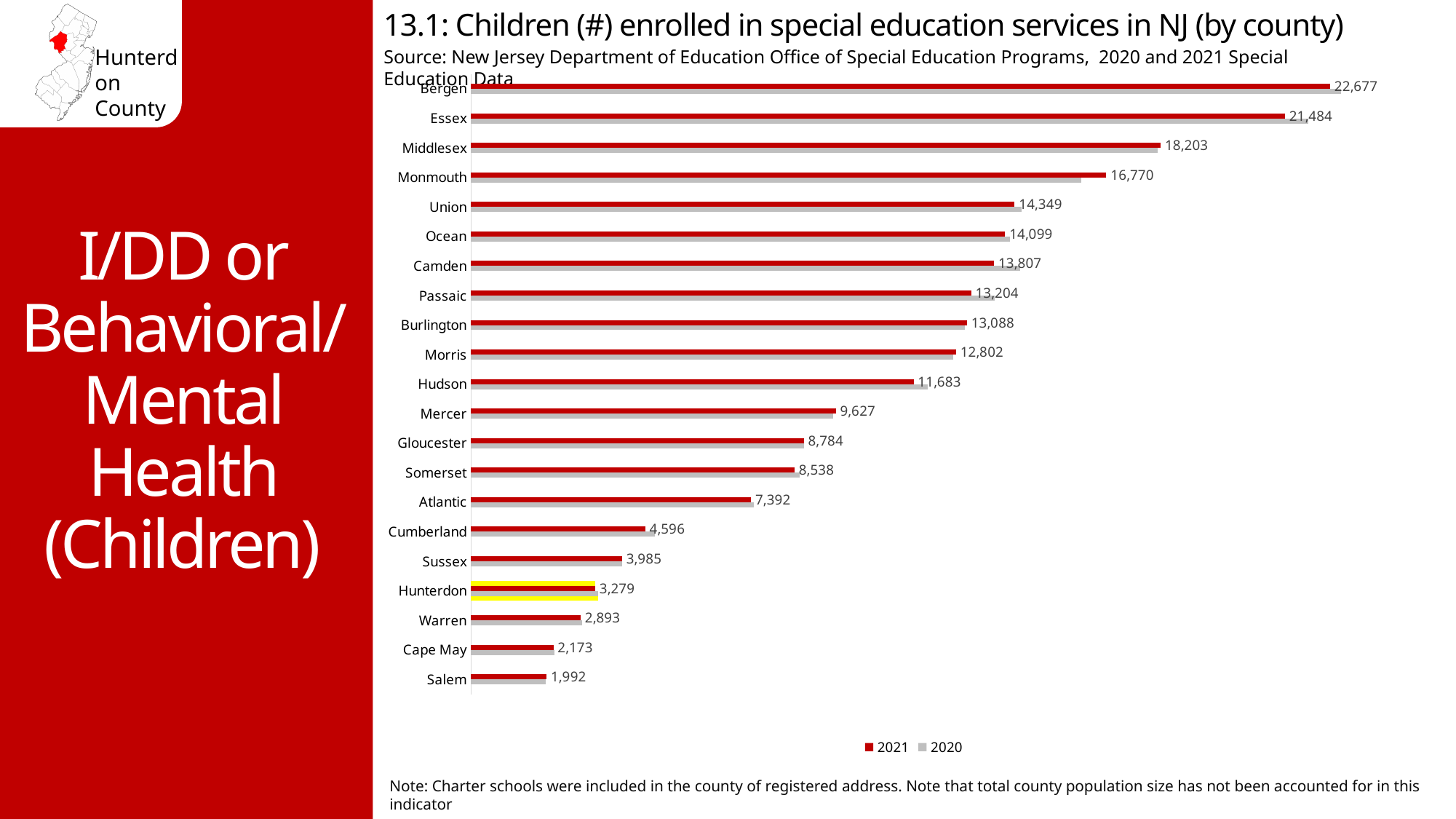
What is the difference between the 2021 values for Bergen and Essex? 1,193 How many series does the legend list? 2 Which has a larger 2021 value, Mercer or Gloucester? Mercer Which county has the highest 2021 value? Bergen What is the 2021 value for Cape May? 2,173 Which county's bars are highlighted in yellow? Hunterdon Which county has the lowest 2021 value? Salem What kind of chart is shown? Bar chart How many counties are shown on the chart? 21 What is the 2021 value for Hunterdon? 3,279 What is the difference between the 2021 values for Hunterdon and Warren? 386 What is the 2021 value for Bergen? 22,677